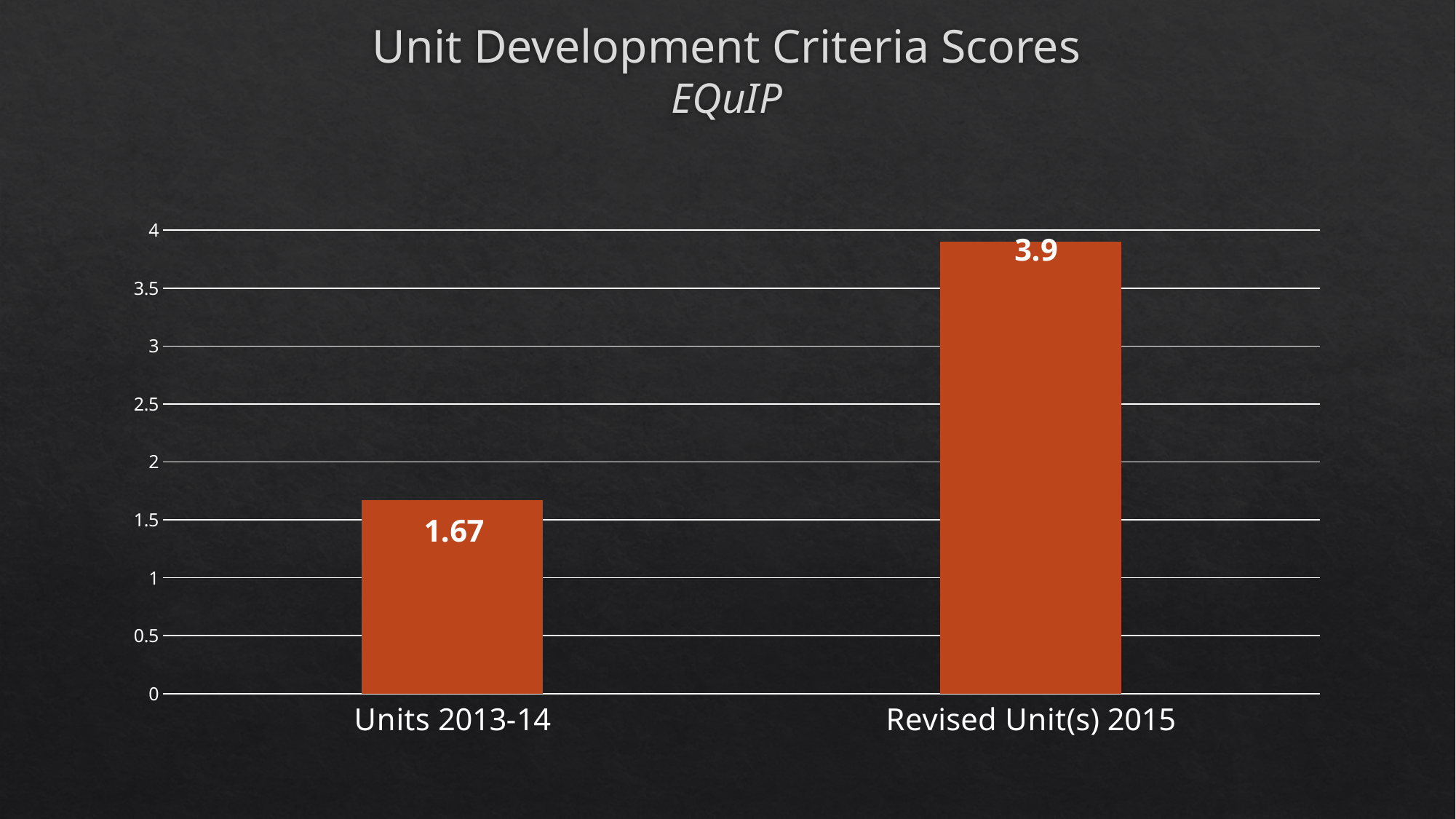
What is the title of the chart? Unit Development Criteria Scores EQuIP Which category has the highest value? Revised Unit(s) 2015 Which category has the lowest value? Units 2013-14 Which is larger, the value for Units 2013-14 or the value for Revised Unit(s) 2015? Revised Unit(s) 2015 What is the difference between the values for Revised Unit(s) 2015 and Units 2013-14? 2.23 Is the value for Revised Unit(s) 2015 greater or less than 3.5? greater Do the values rise or fall from Units 2013-14 to Revised Unit(s) 2015? rise How many categories are shown on the x axis? 2 What kind of chart is shown on the slide? bar chart What is the value for Units 2013-14? 1.67 Is the value for Units 2013-14 greater or less than 2? less What is the value for Revised Unit(s) 2015? 3.9